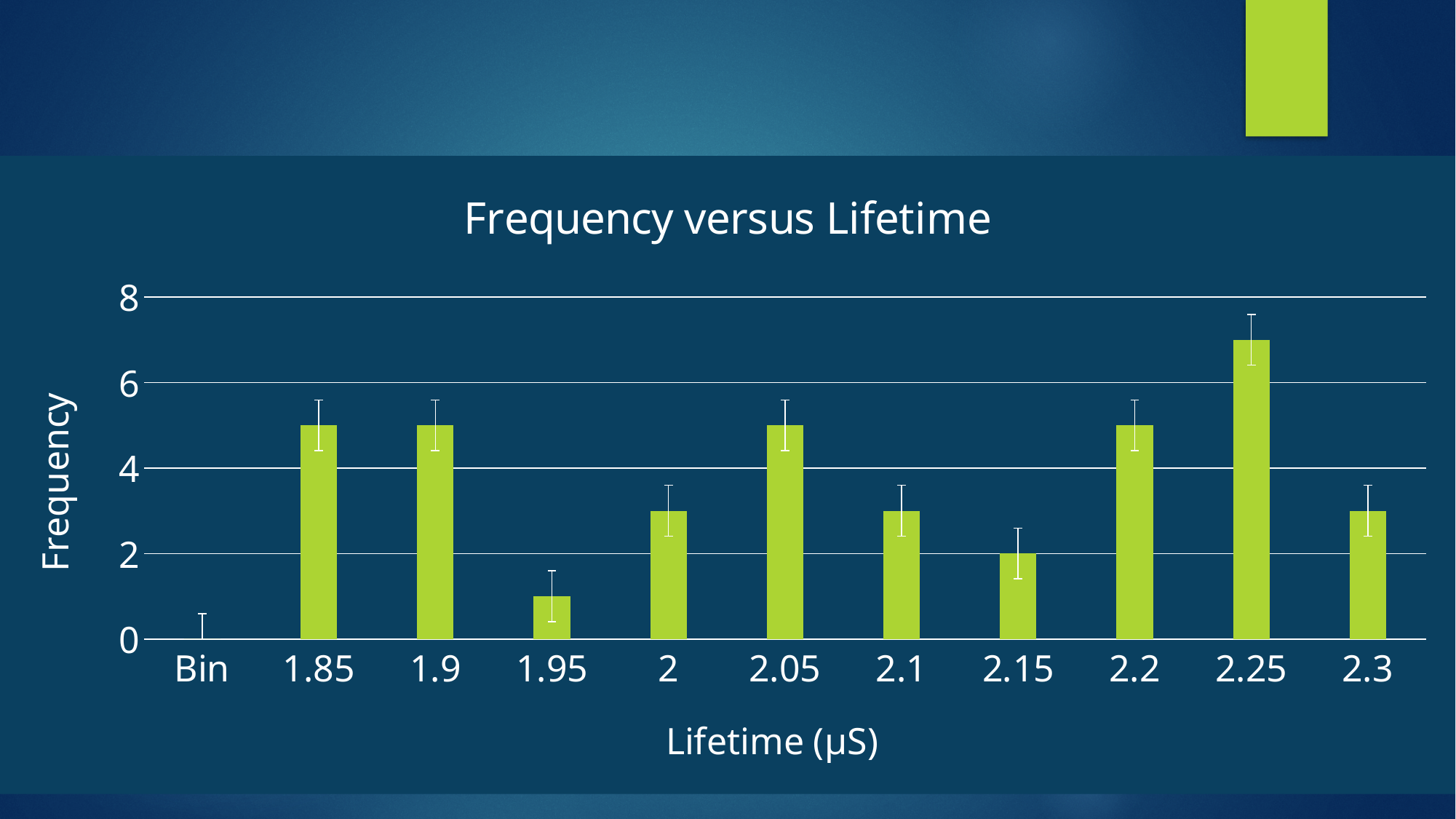
Is the frequency for 2.3 greater or less than 4? less What is the label of the x axis? Lifetime (µS) What is the title of the chart? Frequency versus Lifetime Which has the larger frequency, 1.95 or 2? 2 Which has the larger frequency, 2.2 or 2.25? 2.25 Is the frequency for 1.95 greater or less than 2? less Is the frequency for 1.85 greater or less than 4? greater What kind of chart is shown on the slide? bar chart What is the frequency for the 2.15 category? 2 How many categories are shown on the x axis? 11 Which category has the highest frequency? 2.25